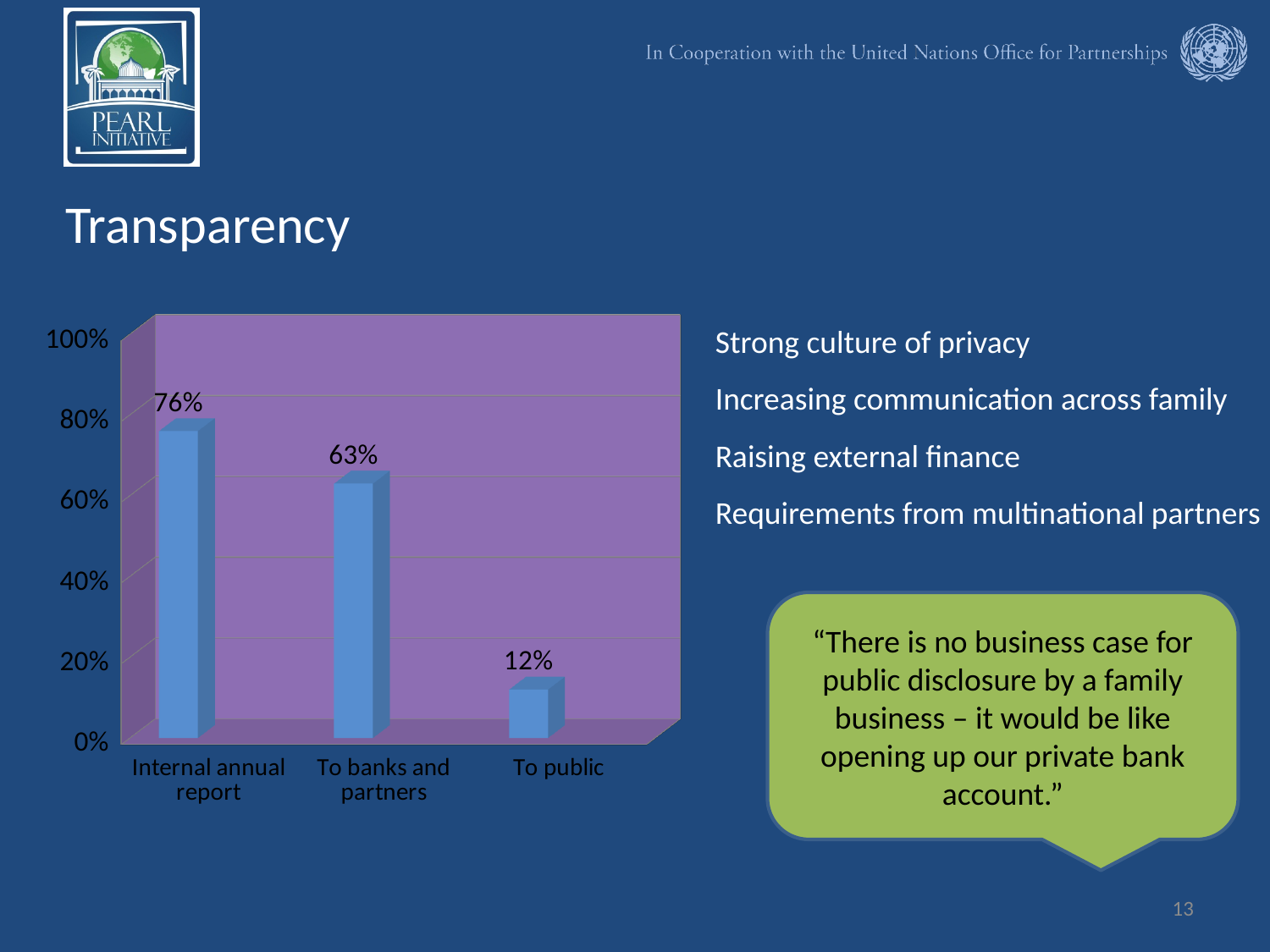
What is the value for Internal annual report? 76% Which category has the lowest value? To public Do the values rise or fall from left to right along the x axis? fall What is the value for To banks and partners? 63% What is the difference between the values for Internal annual report and To banks and partners? 13% What kind of chart is shown on the slide? bar chart What is the value for To public? 12% How many categories are shown on the chart? 3 Is the value for To banks and partners greater or less than 40%? greater Which category has the highest value? Internal annual report Which is larger, the value for To banks and partners or the value for To public? To banks and partners What is the difference between the values for Internal annual report and To public? 64%